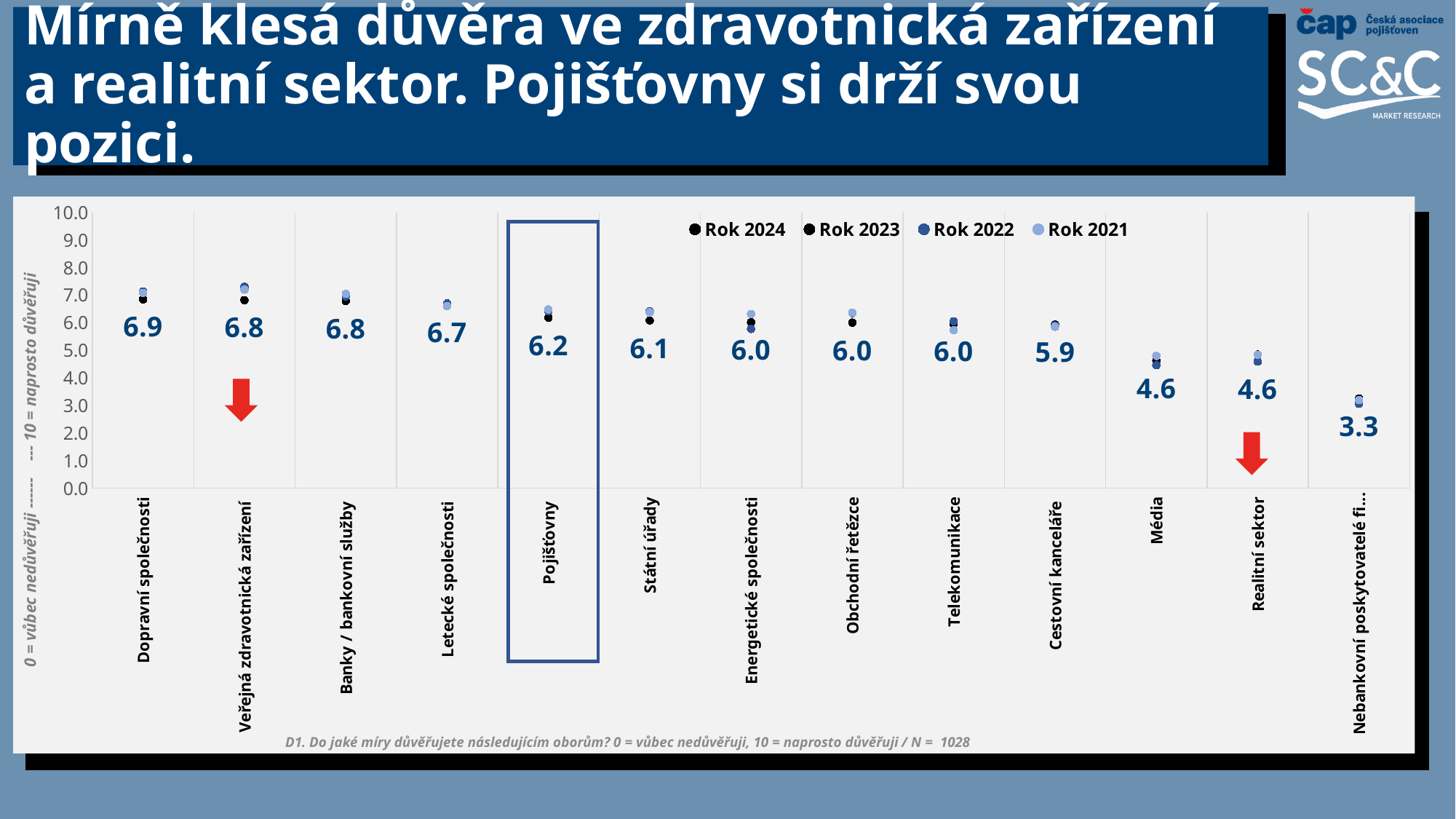
Which category has the lowest labelled value? Nebankovní poskytovatelé fi... Which category is highlighted with a rectangular outline on the chart? Pojišťovny What is the labelled value for Dopravní společnosti? 6.9 Which category has the highest labelled value? Dopravní společnosti What is the labelled value for Média? 4.6 How many series does the legend list? 4 How many categories are shown on the x axis? 13 What is the labelled value for Pojišťovny? 6.2 Is the labelled value for Telekomunikace greater or less than 5.0? greater What is the labelled value for Cestovní kanceláře? 5.9 Which has a larger labelled value, Letecké společnosti or Státní úřady? Letecké společnosti What is the difference between the labelled values for Dopravní společnosti and Realitní sektor? 2.3